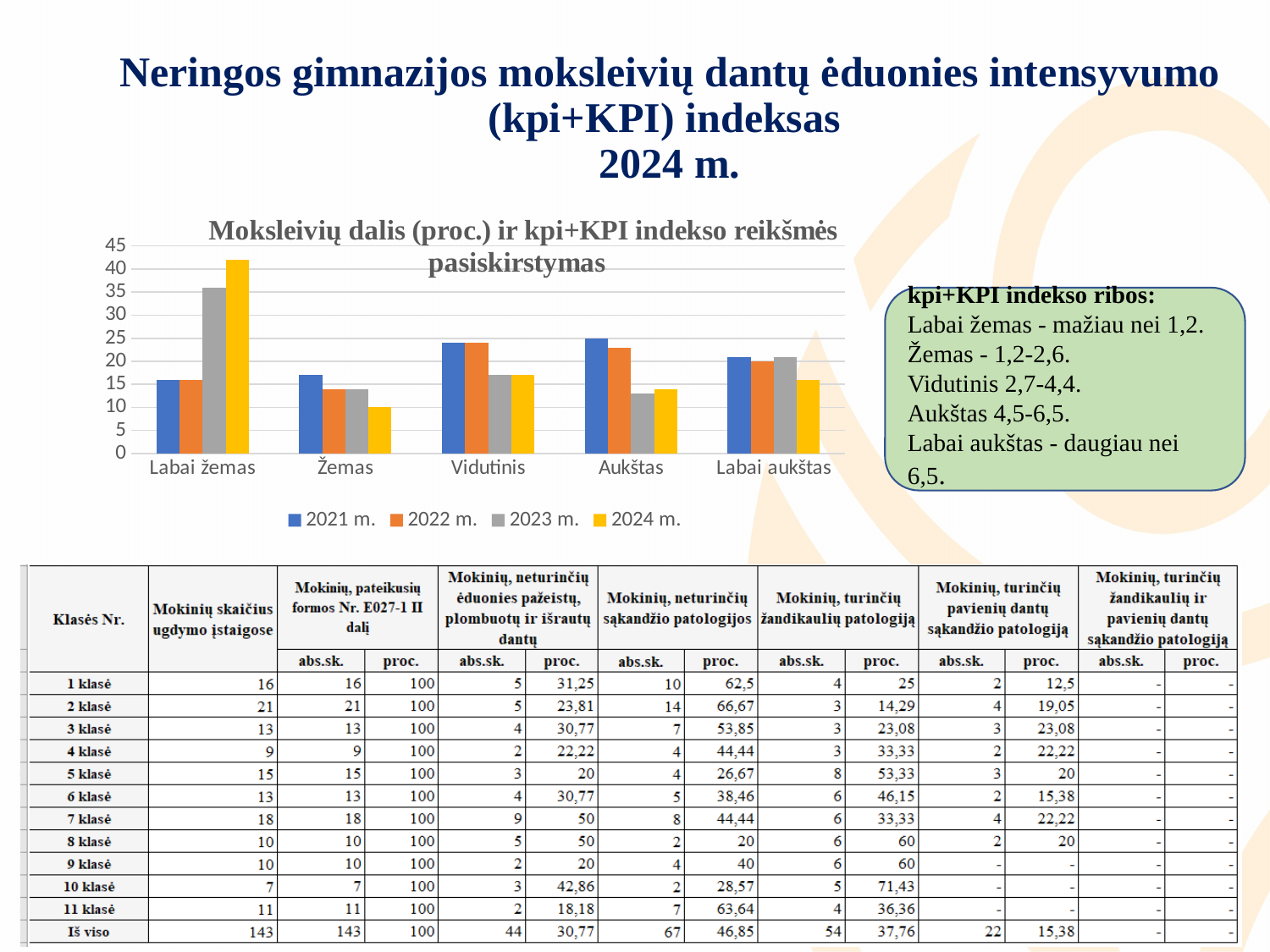
Which category has the highest bar for 2023 m.? Labai žemas In the Aukštas category, which is larger: the 2021 m. bar or the 2024 m. bar? 2021 m. Is the value for 2024 m. in the Žemas category greater or less than 15? less Which category has the highest bar for 2024 m.? Labai žemas Is the value for 2024 m. in the Labai žemas category greater or less than 40? greater What kind of chart is shown on the slide? bar chart How many series does the chart legend list? 4 Is the value for 2023 m. in the Labai žemas category greater or less than 30? greater In the Labai žemas category, which is larger: the 2023 m. bar or the 2024 m. bar? 2024 m. Which category has the lowest bar for 2024 m.? Žemas How many categories are shown along the x axis of the chart? 5